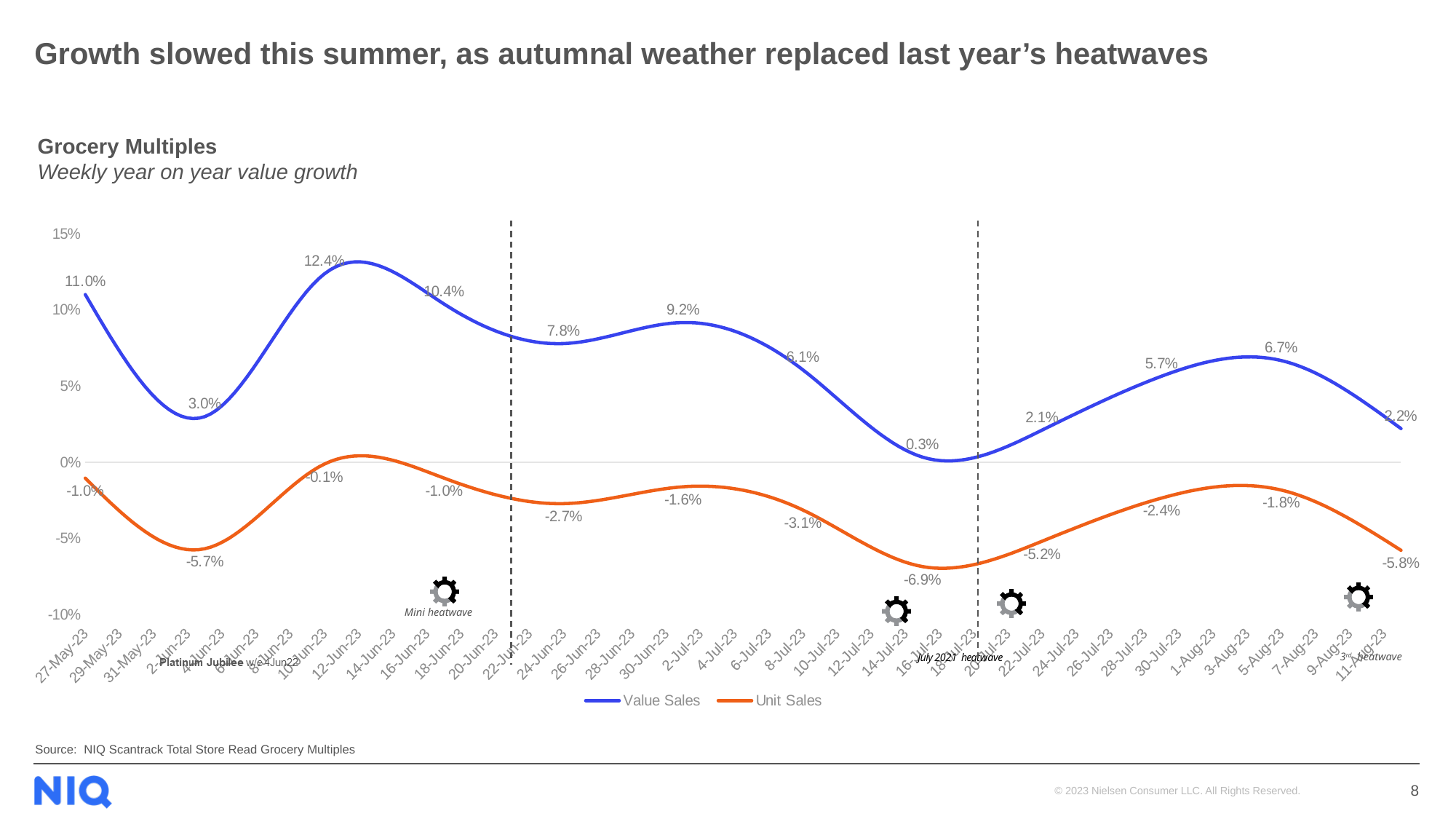
How many labelled data points are there on the Value Sales line? 12 What is the first labelled value on the Value Sales line, at the left of the chart? 11.0% Which series is higher at the final point on the right of the chart, Value Sales or Unit Sales? Value Sales What is the highest labelled value on the Unit Sales line? -0.1% What is the difference between the highest (12.4%) and lowest (0.3%) labelled Value Sales values? 12.1 percentage points What type of chart is shown on the slide? Line chart What is the last labelled value on the Unit Sales line, at the right of the chart? -5.8% How many series does the legend list? 2 What is the lowest labelled value on the Value Sales line? 0.3% What is the lowest labelled value on the Unit Sales line? -6.9% Which colour is used for the Unit Sales line? Orange What is the highest labelled value on the Value Sales line? 12.4%